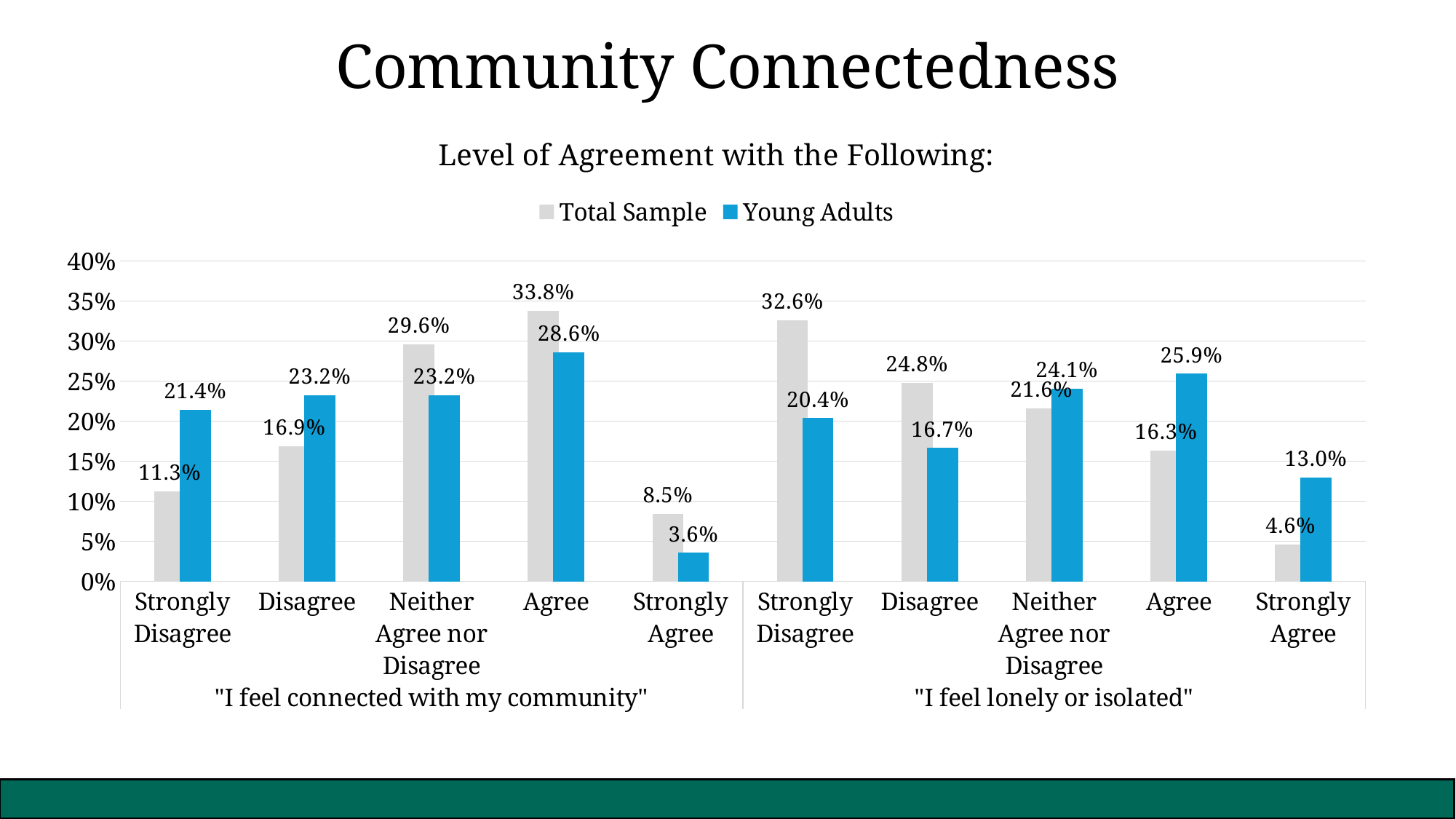
What kind of chart is shown on the slide? Bar chart How many response categories are shown under "I feel lonely or isolated"? 5 Is the Total Sample value for "Neither Agree nor Disagree" under "I feel connected with my community" greater or less than 25%? greater What is the difference between the Total Sample and Young Adults values for "Strongly Disagree" under "I feel lonely or isolated"? 12.2% Which response category has the lowest Young Adults value under "I feel connected with my community"? Strongly Agree What is the Young Adults value for "Strongly Agree" under "I feel lonely or isolated"? 13.0% What is the Total Sample value for "Agree" under "I feel connected with my community"? 33.8% What is the Young Adults value for "Strongly Disagree" under "I feel connected with my community"? 21.4% For "Agree" under "I feel lonely or isolated", which is larger: Total Sample or Young Adults? Young Adults How many series does the legend list? 2 Which response category has the highest Total Sample value under "I feel lonely or isolated"? Strongly Disagree What is the subtitle of the chart? Level of Agreement with the Following: